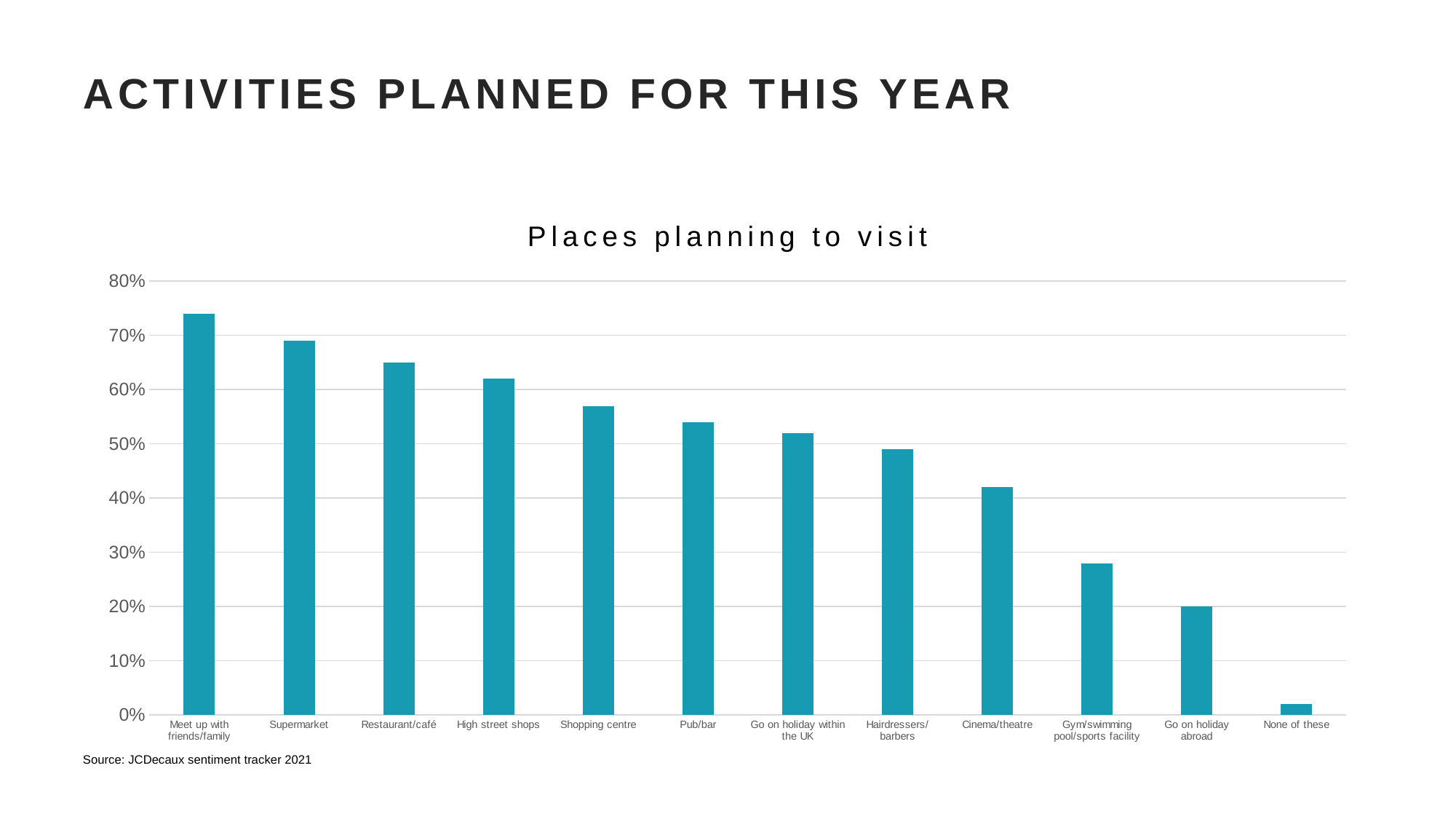
Which category has the lowest value in the chart? None of these Is the value for Gym/swimming pool/sports facility greater or less than 30%? less Do the values rise or fall moving from left to right along the x axis? fall Which is larger, the value for Pub/bar or the value for Hairdressers/barbers? Pub/bar What is the title of the chart? Places planning to visit How many categories are plotted in the 'Places planning to visit' chart? 12 Is the value for Meet up with friends/family greater or less than 70%? greater Is the value for Supermarket greater or less than 60%? greater Which is larger, the value for Go on holiday abroad or the value for Cinema/theatre? Cinema/theatre Which category has the highest value in the chart? Meet up with friends/family What kind of chart is shown on the slide? bar chart